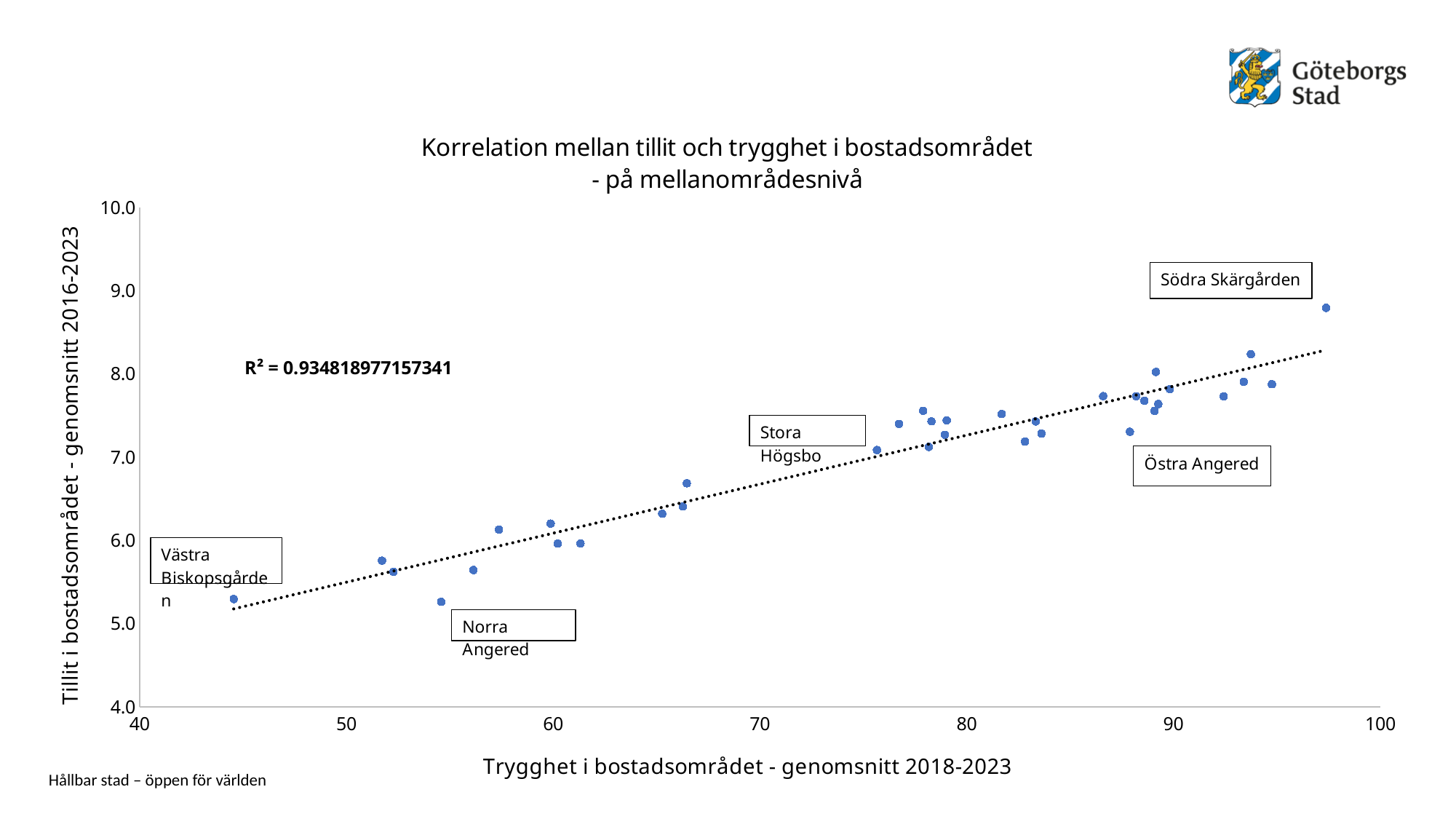
Do the tillit values generally rise or fall as trygghet increases along the x axis? Rise Is the trygghet value for Västra Biskopsgården greater or less than 50? less What is the title of the chart? Korrelation mellan tillit och trygghet i bostadsområdet - på mellanområdesnivå Is the trygghet value for Södra Skärgården greater or less than 90? greater Which has a higher tillit value, Södra Skärgården or Västra Biskopsgården? Södra Skärgården Is the tillit value for Norra Angered greater or less than 6.0? less What is the title of the x axis? Trygghet i bostadsområdet - genomsnitt 2018-2023 What kind of chart is shown on the slide? Scatter chart Which of the labelled areas has the highest tillit value? Södra Skärgården What R² value is printed on the chart? R² = 0.934818977157341